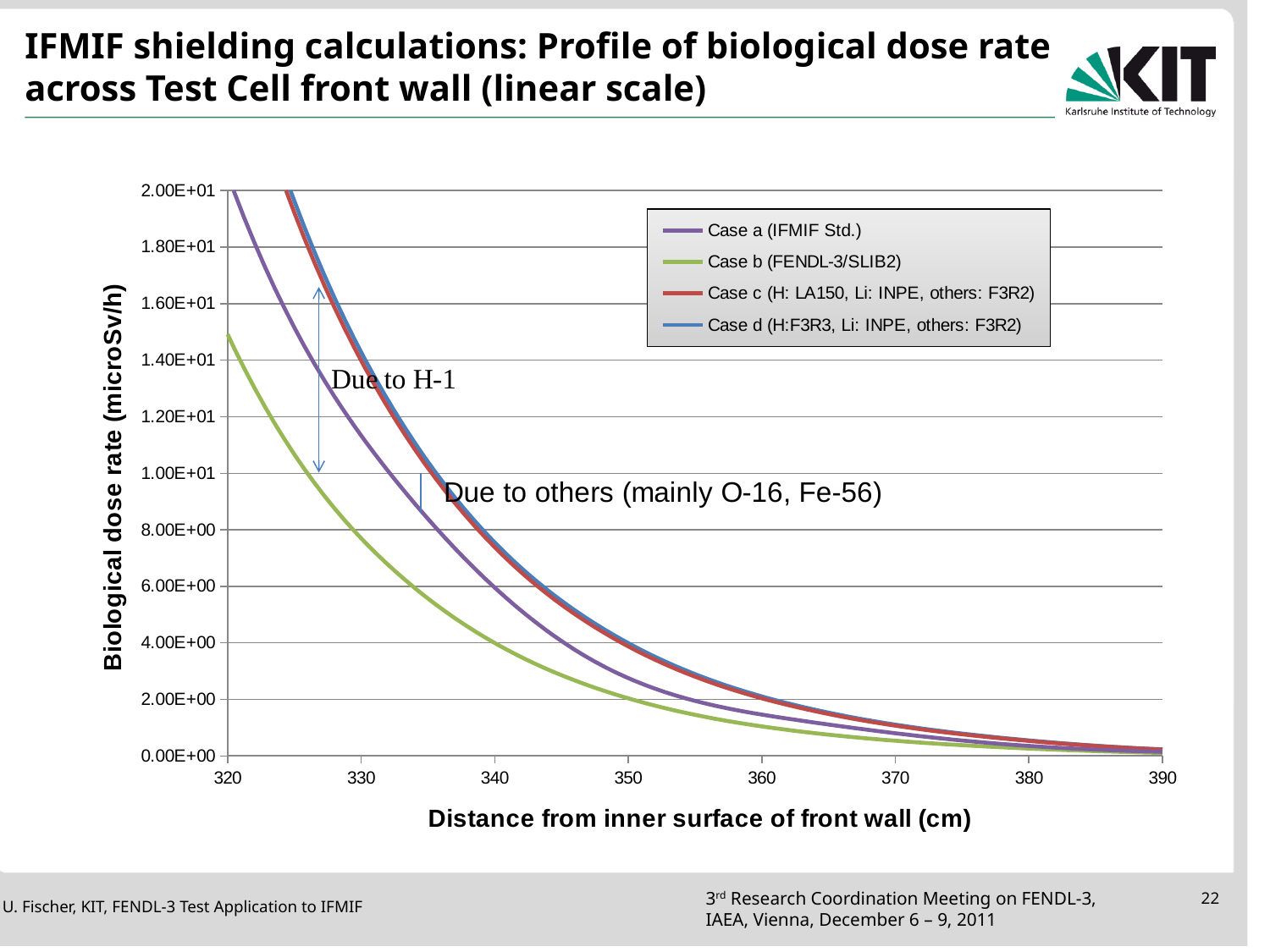
Is the value for Case b (FENDL-3/SLIB2) at 360 cm greater or less than 2.00E+00? less Is the value for Case b (FENDL-3/SLIB2) at 320 cm greater or less than 1.40E+01? greater At 340 cm, which is larger: the value for Case c (H: LA150, Li: INPE, others: F3R2) or for Case b (FENDL-3/SLIB2)? Case c (H: LA150, Li: INPE, others: F3R2) Is the value for Case c (H: LA150, Li: INPE, others: F3R2) at 340 cm greater or less than 8.00E+00? less How many series does the legend list? 4 Which series has the lowest biological dose rate at 340 cm? Case b (FENDL-3/SLIB2) What is the title of the y axis? Biological dose rate (microSv/h) Do the biological dose rate values rise or fall as the distance from the inner surface of the front wall increases? fall What is the title of the x axis? Distance from inner surface of front wall (cm) What kind of chart is shown on the slide? line chart